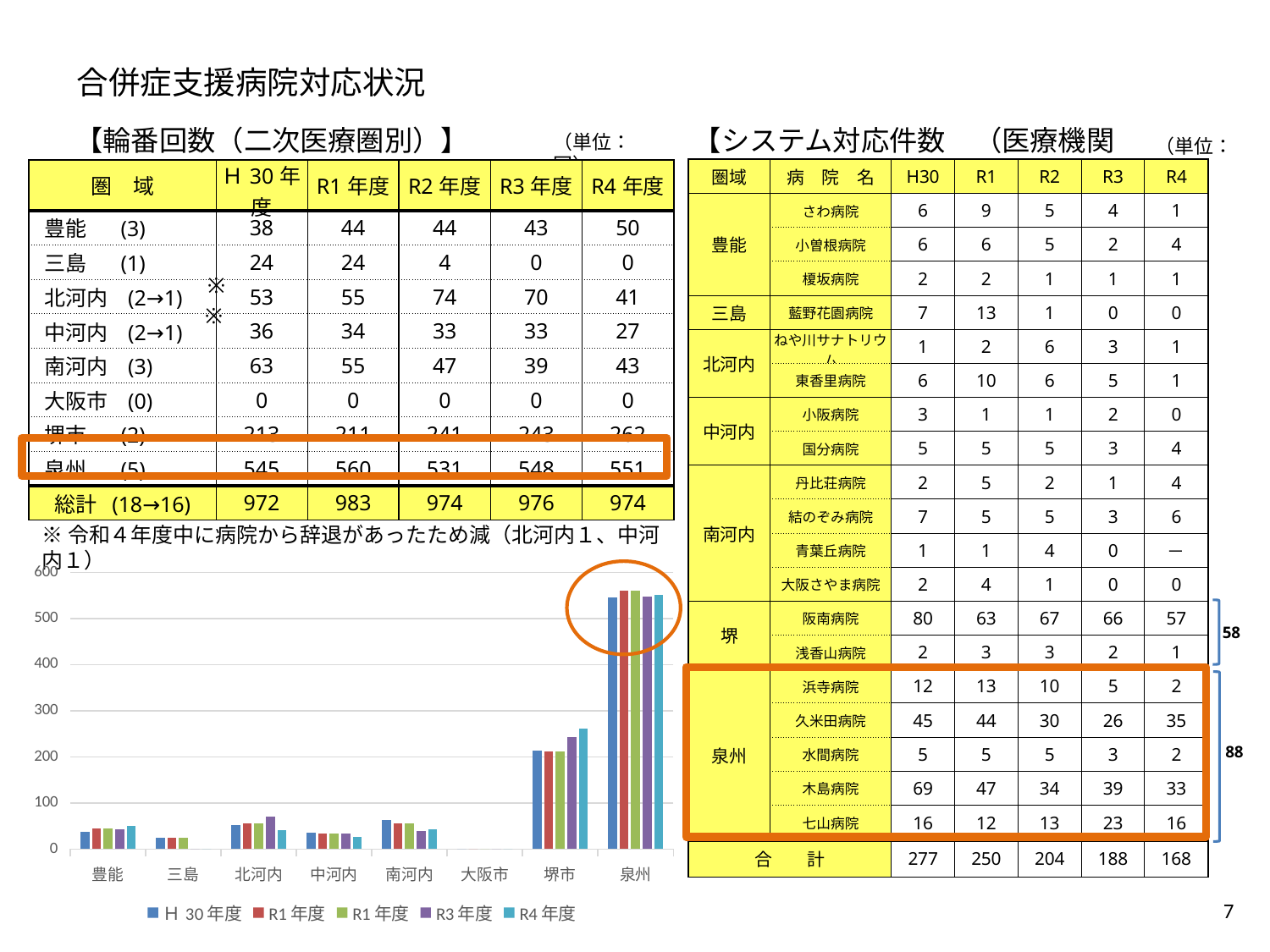
How many series does the legend of the bar chart list? 5 In the bar chart, which category has the larger R4 年度 value, 堺市 or 泉州? 泉州 According to the table above the bar chart, what is the H 30 年度 value for 豊能? 38 What is the first series entry listed in the legend of the bar chart? H 30 年度 Which category has the highest bars in the bar chart? 泉州 In the bar chart, is the H 30 年度 value for 泉州 greater or less than 500? greater What kind of chart is shown at the bottom left of the slide? bar chart In the bar chart, is the R4 年度 value for 堺市 greater or less than 300? less In the bar chart, do the values for 三島 rise or fall from H 30 年度 to R4 年度? fall How many categories are shown on the x axis of the bar chart? 8 Which category has the lowest values in the bar chart, with no visible bars at all? 大阪市